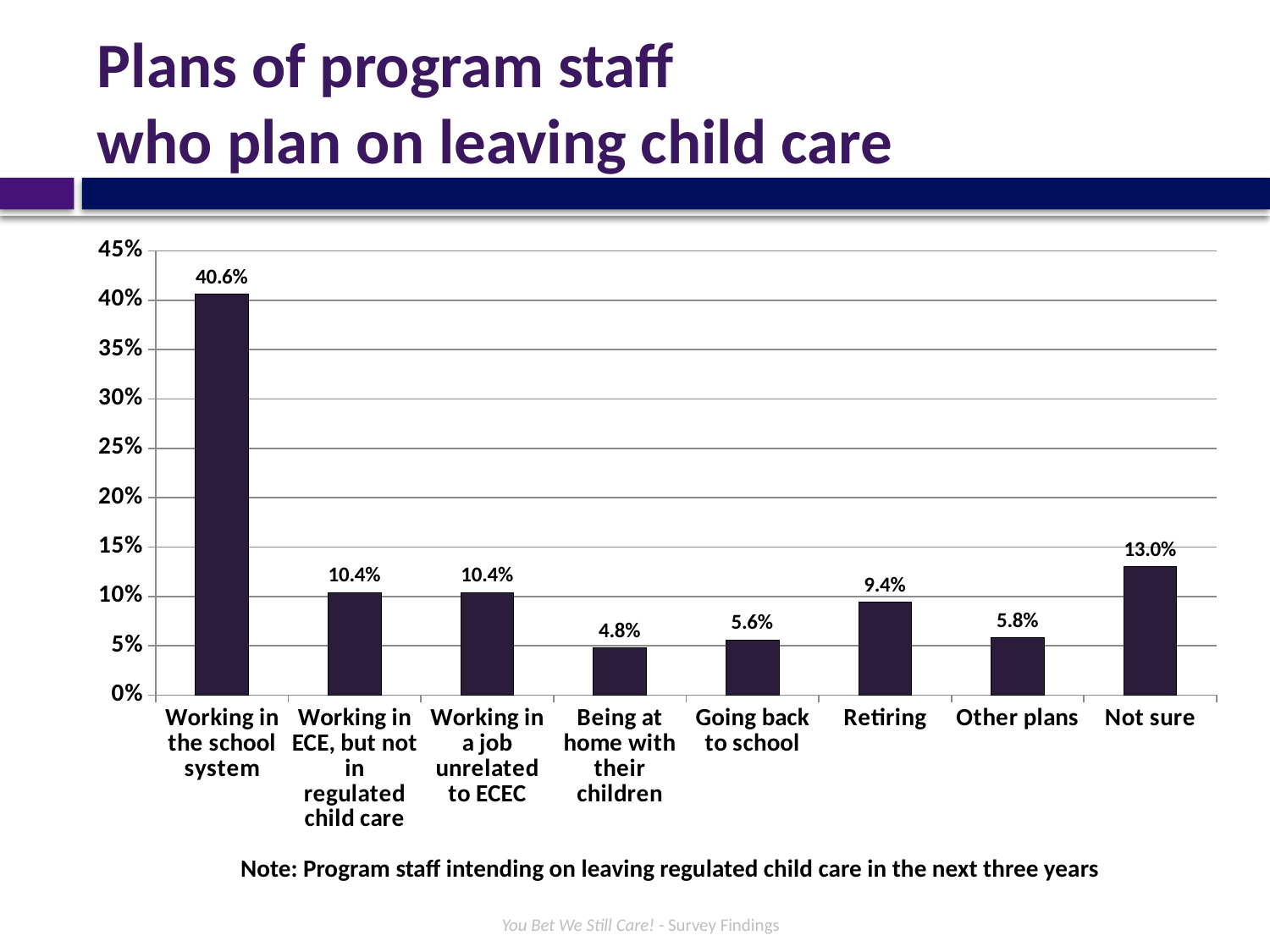
Which is larger, 'Other plans' or 'Retiring'? Retiring What is the value for 'Not sure'? 13.0% How many categories are shown on the x axis? 8 Which category has the lowest value? Being at home with their children What kind of chart is shown on the slide? Bar chart What is the difference between 'Retiring' and 'Going back to school'? 3.8% What is the value for 'Retiring'? 9.4% What percentage of program staff who plan on leaving child care plan on working in the school system? 40.6% Which category has the highest value? Working in the school system What is the difference between 'Working in the school system' and 'Not sure'? 27.6% What is the title of the slide? Plans of program staff who plan on leaving child care What is the value for 'Being at home with their children'? 4.8%